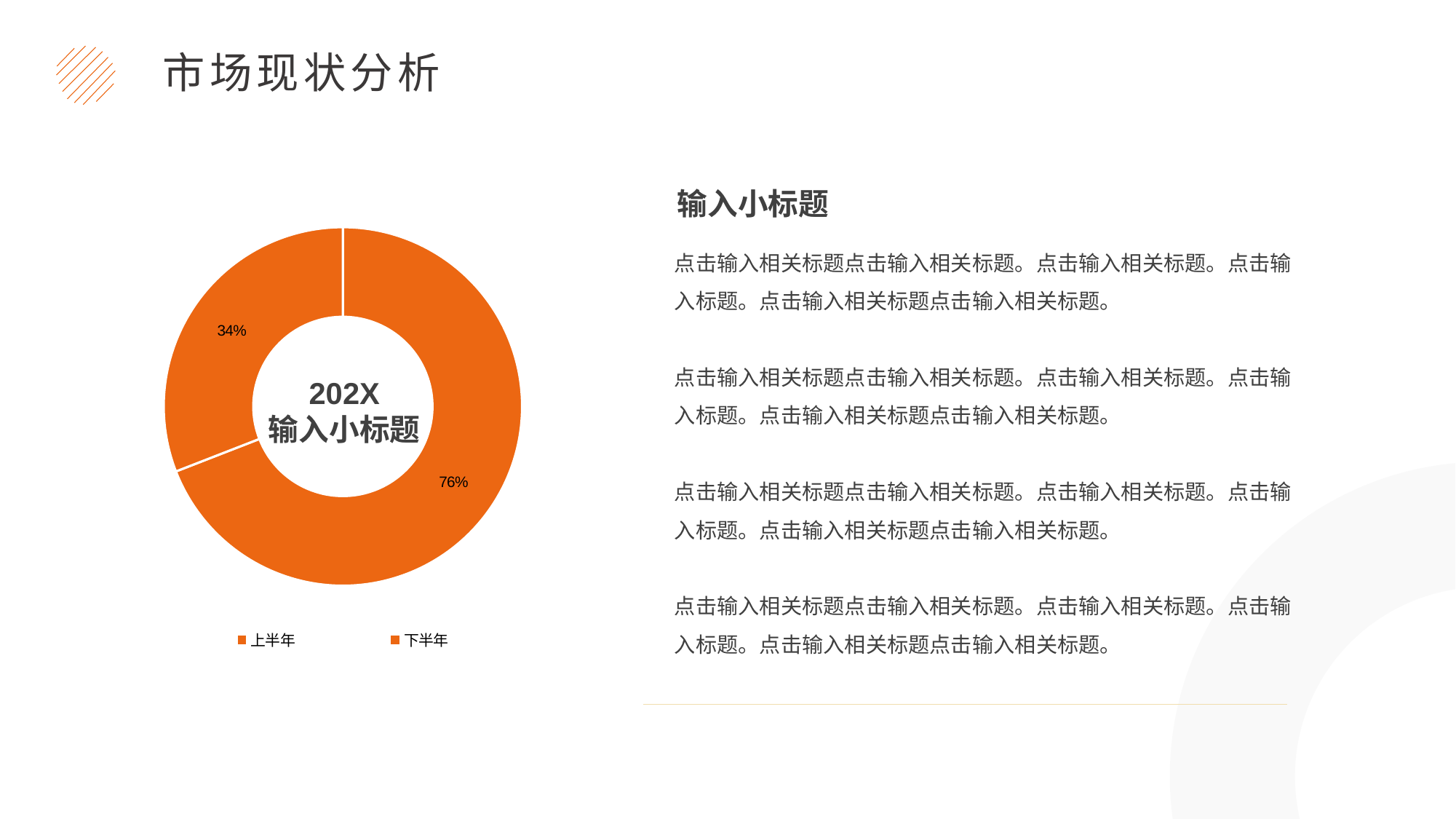
What kind of chart is shown on the slide? Doughnut (pie) chart What are the two legend entries of the chart? 上半年 and 下半年 What is the percentage shown on the largest slice of the doughnut chart? 76% How many entries does the chart legend list? 2 What is the difference in percentage points between the two slice labels (76% and 34%)? 42 percentage points What text is printed in the centre of the doughnut chart? 202X 输入小标题 What is the percentage shown on the smallest slice of the doughnut chart? 34% How many slices does the doughnut chart have? 2 Which slice label is larger, 34% or 76%? 76%